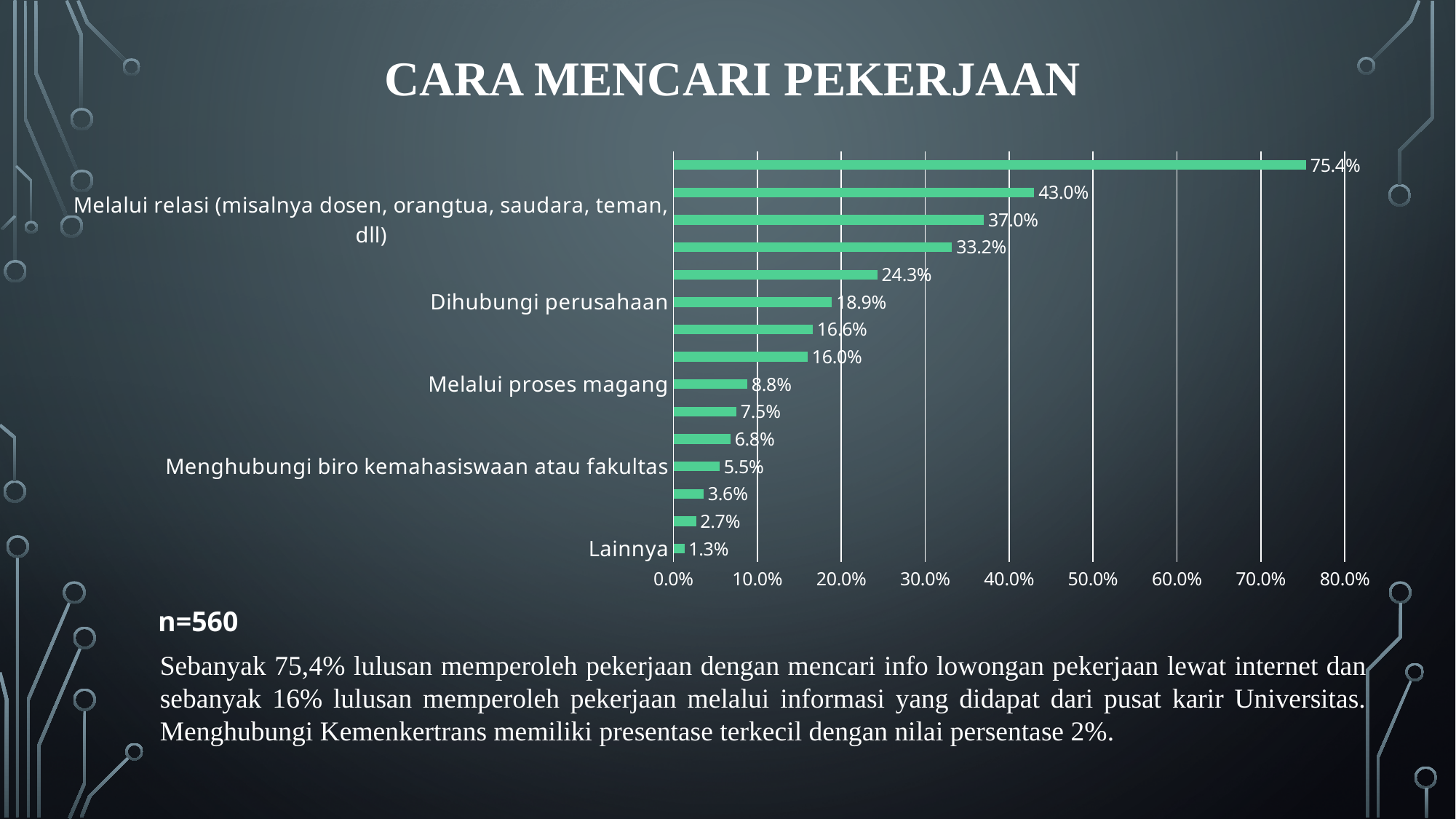
Which category has the lowest value? Lainnya What is the highest value shown in the chart? 75.4% What is the value for Dihubungi perusahaan? 18.9% What is the value for Melalui proses magang? 8.8% What is the value for Lainnya? 1.3% What is the value for Menghubungi biro kemahasiswaan atau fakultas? 5.5% What is the title of the chart? CARA MENCARI PEKERJAAN Which is larger, the value for Melalui proses magang or the value for Menghubungi biro kemahasiswaan atau fakultas? Melalui proses magang How many bars does the chart contain? 15 What is the value for Melalui relasi (misalnya dosen, orangtua, saudara, teman, dll)? 37.0% What kind of chart is shown on the slide? bar chart What is the difference between the values for Dihubungi perusahaan and Melalui proses magang? 10.1%